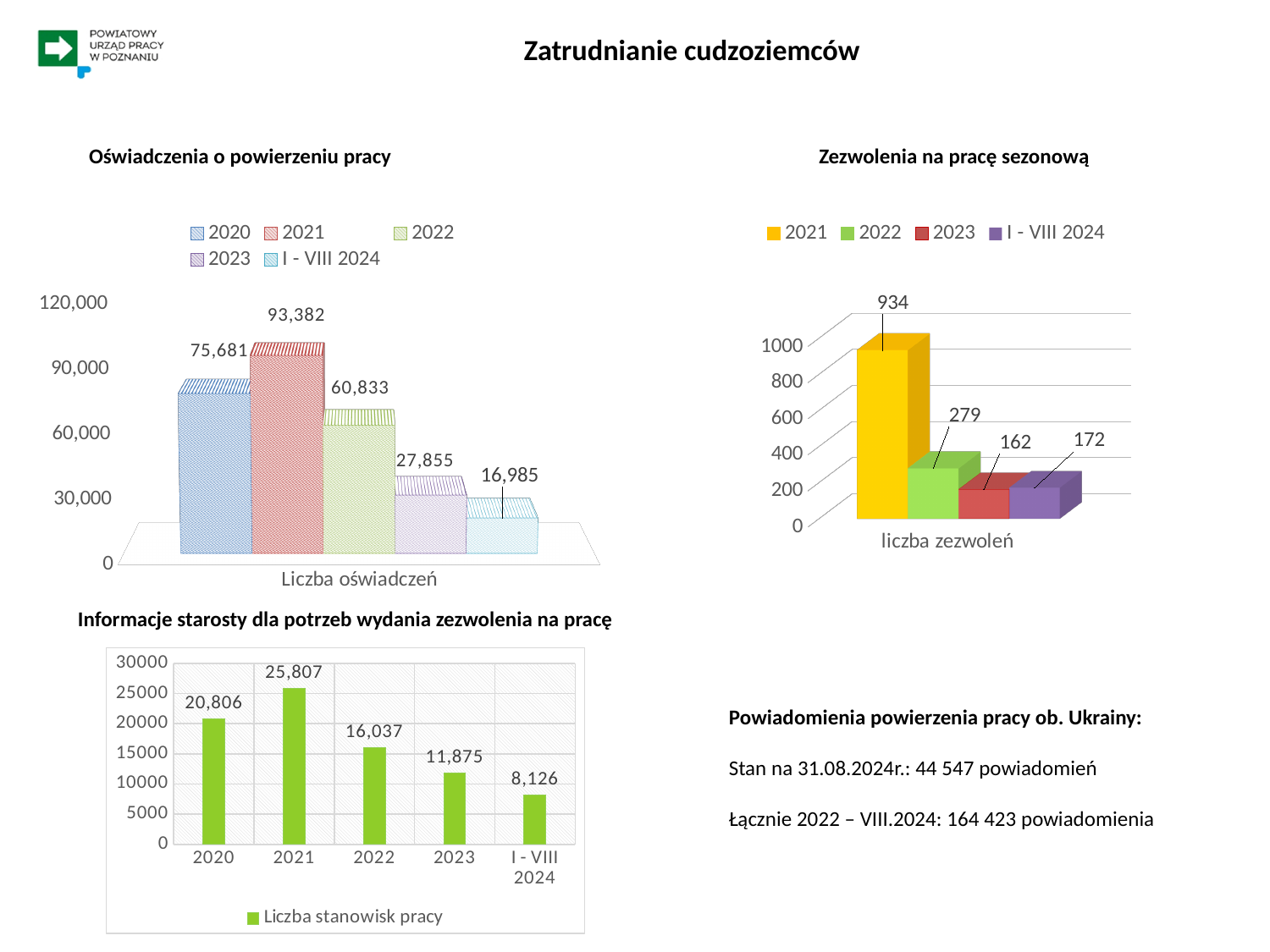
What kind of chart is the 'Informacje starosty dla potrzeb wydania zezwolenia na pracę' chart? bar chart In the 'Oświadczenia o powierzeniu pracy' chart, what is the value for 2021? 93,382 In the 'Zezwolenia na pracę sezonową' chart, which series has the highest value? 2021 In the 'Informacje starosty dla potrzeb wydania zezwolenia na pracę' chart, do the values rise or fall from 2021 to I - VIII 2024? fall In the 'Informacje starosty dla potrzeb wydania zezwolenia na pracę' chart, how many categories are shown on the x axis? 5 In the 'Oświadczenia o powierzeniu pracy' chart, what is the difference between the 2020 and 2022 values? 14,848 How many series does the legend of the 'Oświadczenia o powierzeniu pracy' chart list? 5 In the 'Informacje starosty dla potrzeb wydania zezwolenia na pracę' chart, what is the value for 2023? 11,875 In the 'Zezwolenia na pracę sezonową' chart, what is the value for 2022? 279 In the 'Zezwolenia na pracę sezonową' chart, is the value for 2023 or for I - VIII 2024 larger? I - VIII 2024 In the 'Oświadczenia o powierzeniu pracy' chart, which series has the lowest value? I - VIII 2024 In the 'Zezwolenia na pracę sezonową' chart, what is the difference between the 2021 and 2022 values? 655